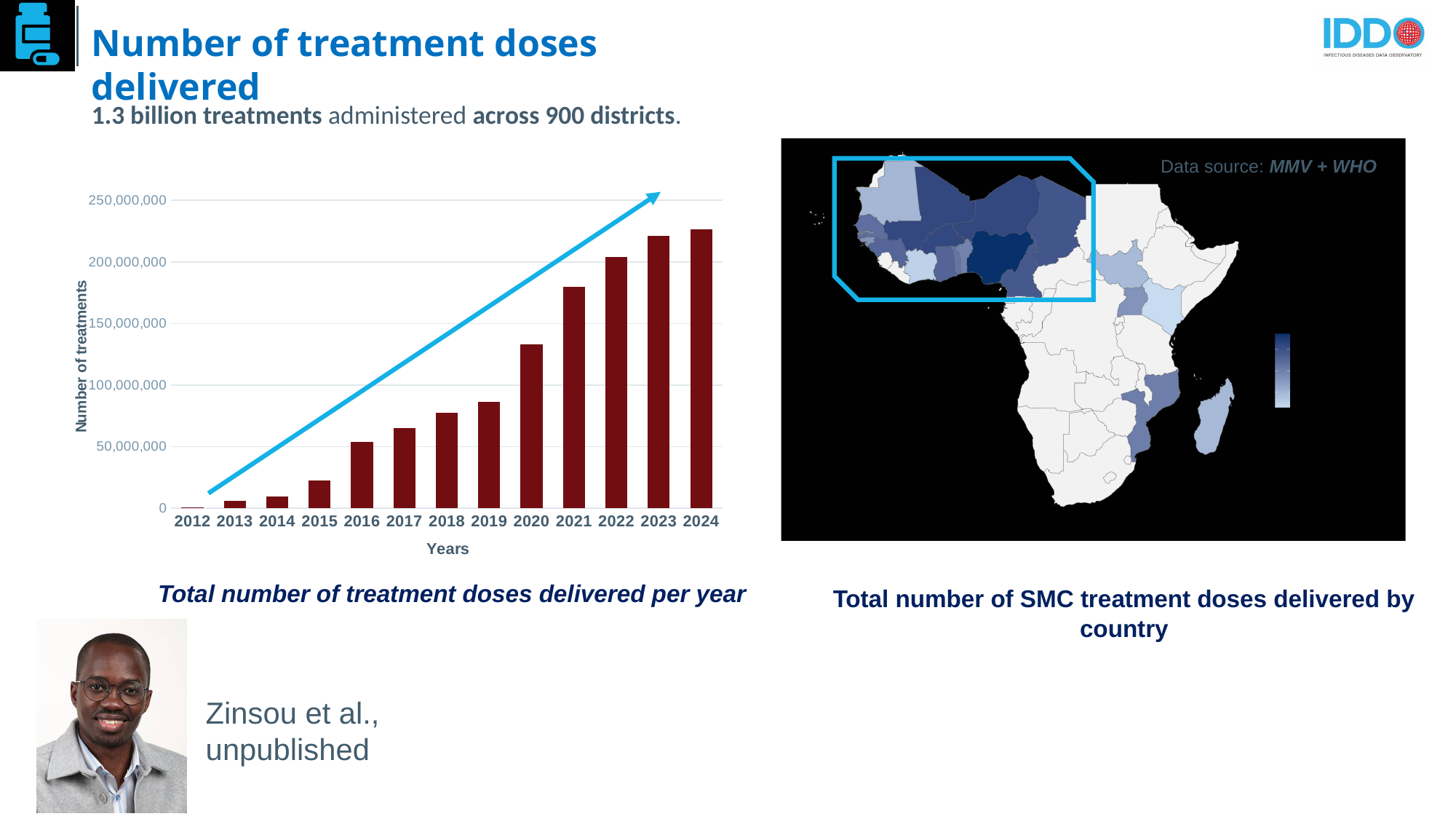
In the bar chart of treatment doses delivered per year, is the value for 2021 greater or less than 150,000,000? greater In the bar chart of treatment doses delivered per year, what is the label on the y axis? Number of treatments In the bar chart of treatment doses delivered per year, do the values generally rise or fall from 2012 to 2024? rise In the bar chart of treatment doses delivered per year, is the value for 2019 greater or less than 100,000,000? less In the bar chart of treatment doses delivered per year, which year has the lowest number of treatments? 2012 In the bar chart of treatment doses delivered per year, is the value for 2023 greater or less than 250,000,000? less In the bar chart of treatment doses delivered per year, which year has the larger value, 2017 or 2021? 2021 In the bar chart of treatment doses delivered per year, how many years are shown on the x axis? 13 In the bar chart of treatment doses delivered per year, what is the label on the x axis? Years What kind of chart is the chart titled 'Total number of treatment doses delivered per year'? bar chart